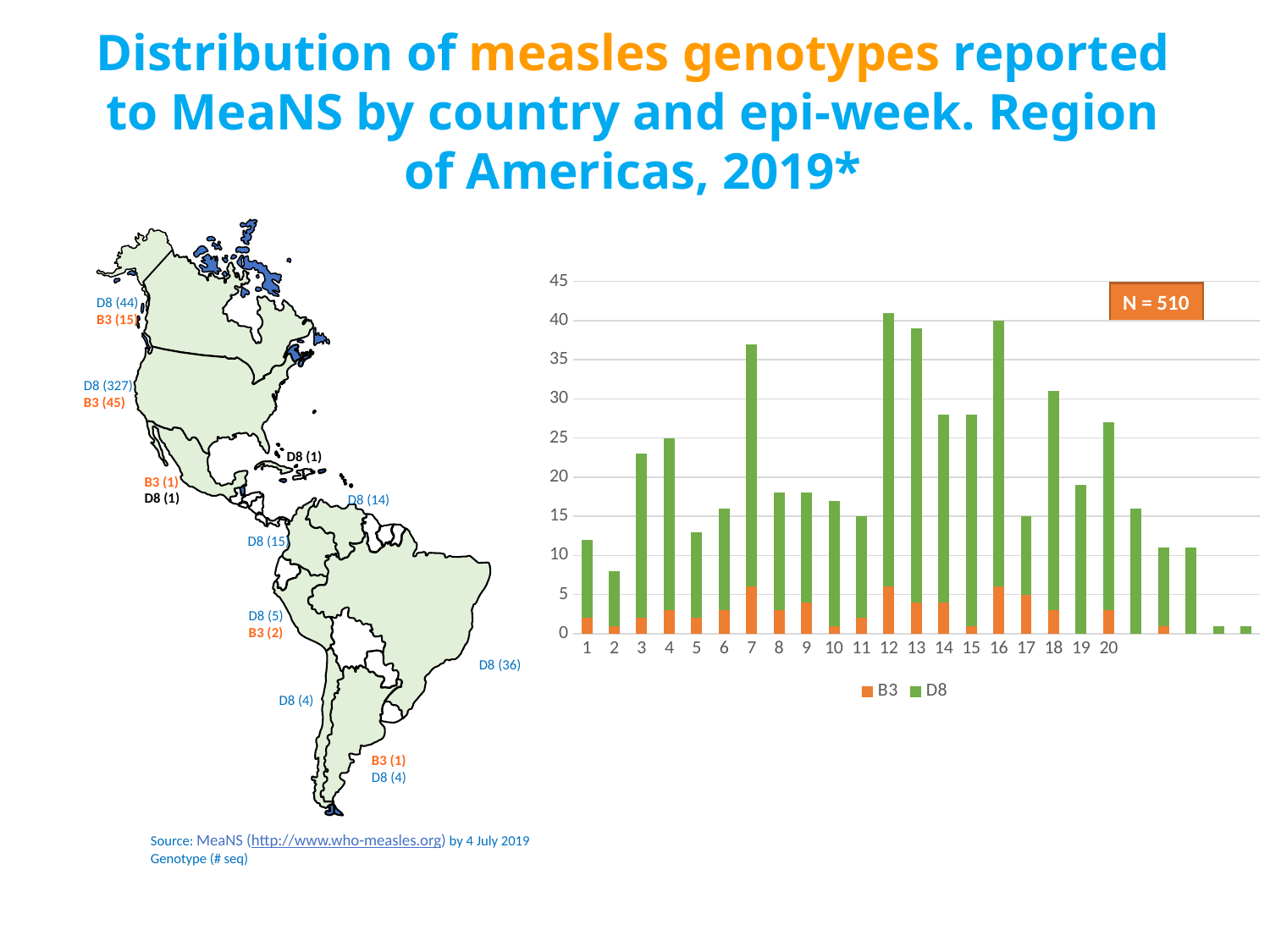
Is the total value for epi-week 7 greater or less than 35? greater How many series does the legend of the bar chart list? 2 What kind of chart is shown on the right of the slide? stacked bar chart Which epi-week has the taller bar, week 7 or week 3? week 7 What are the two series named in the legend of the bar chart? B3 and D8 Which epi-week has the taller bar, week 13 or week 14? week 13 Is the total value for epi-week 2 greater or less than 10? less Is the total value for epi-week 1 greater or less than 10? greater Which epi-week has the taller bar, week 11 or week 12? week 12 What total N is shown in the box on the bar chart? N = 510